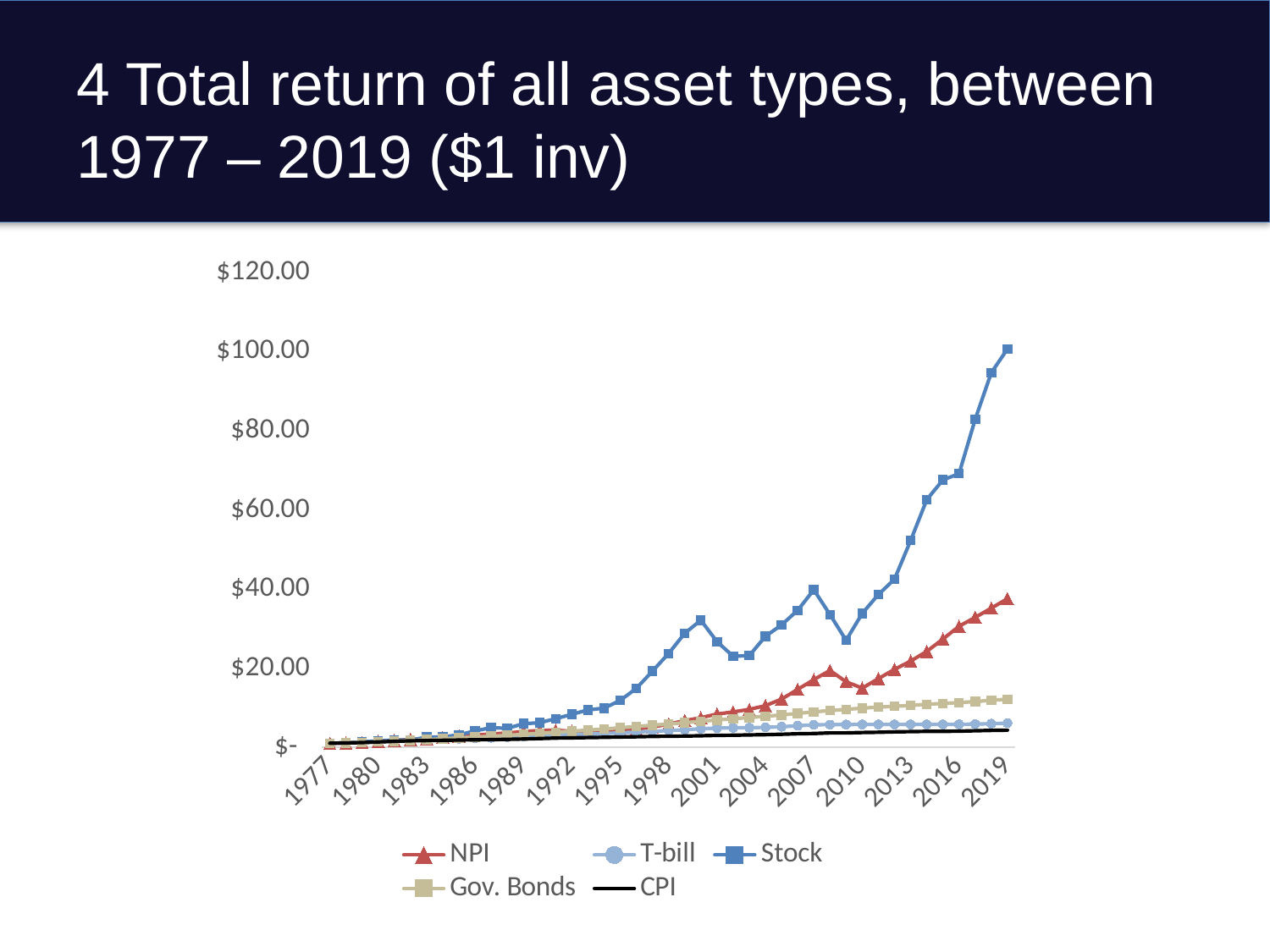
What kind of chart is shown on the slide? Line chart Is the value for Stock in 2019 greater or less than $80.00? greater Which is larger in 2019, the value for NPI or the value for Gov. Bonds? NPI Which series has the lowest value in 2019? CPI Is the value for Gov. Bonds in 2019 greater or less than $20.00? less Which is larger in 2019, the value for T-bill or the value for Stock? Stock How many series does the legend list? 5 Which series is drawn as a black line without markers? CPI What is the title of the slide containing the chart? 4 Total return of all asset types, between 1977 – 2019 ($1 inv) Is the value for NPI in 2019 greater or less than $40.00? less Does the Stock series generally rise or fall from 1977 to 2019? Rise Which series has the highest value in 2019? Stock